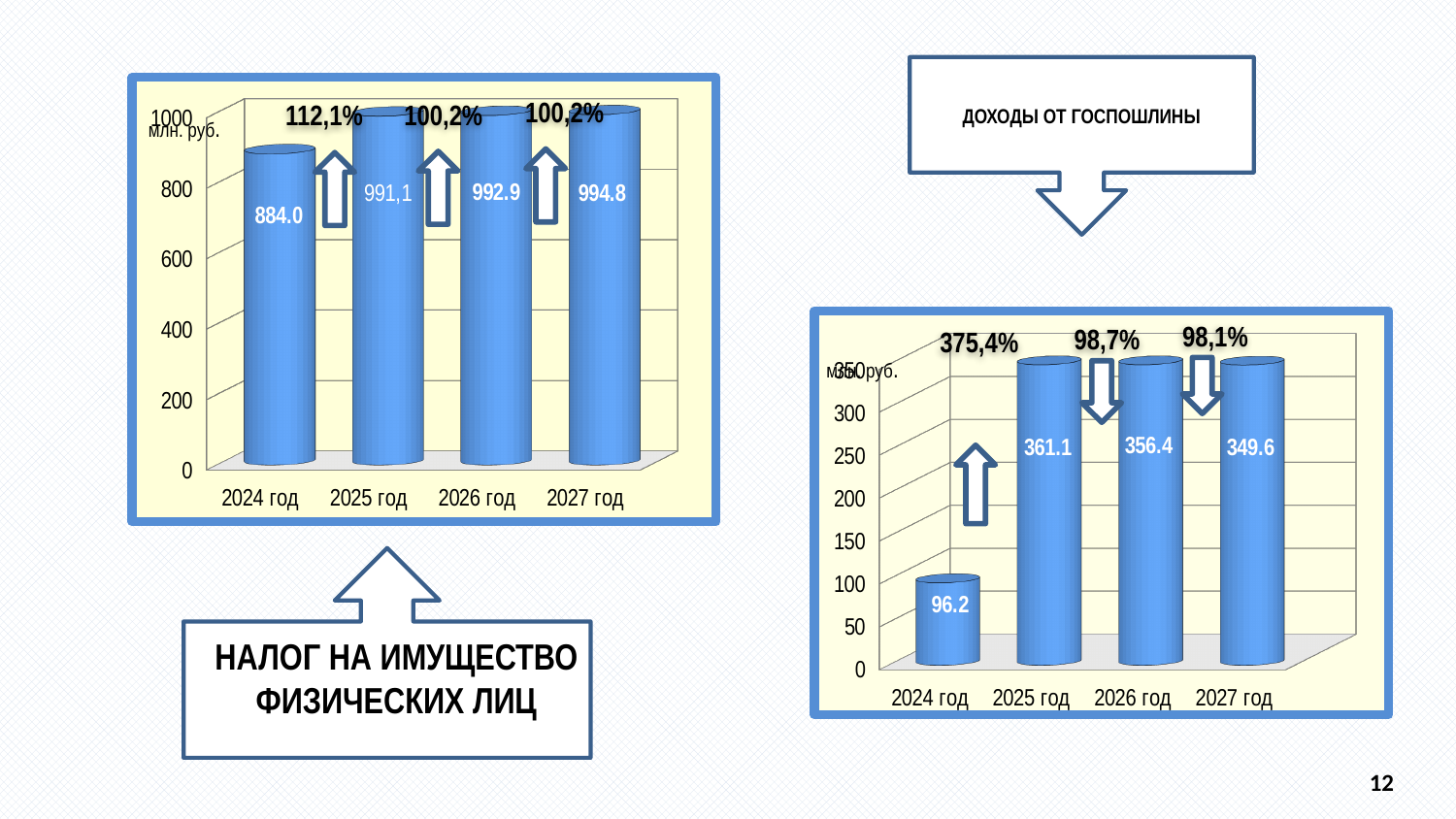
In the right chart (ДОХОДЫ ОТ ГОСПОШЛИНЫ), what is the value for 2026 год? 356.4 In the right chart (ДОХОДЫ ОТ ГОСПОШЛИНЫ), which year has the highest value? 2025 год In the right chart (ДОХОДЫ ОТ ГОСПОШЛИНЫ), what is the value for 2024 год? 96.2 In the left chart (НАЛОГ НА ИМУЩЕСТВО ФИЗИЧЕСКИХ ЛИЦ), what is the difference between the values for 2025 год and 2024 год? 107.1 In the right chart (ДОХОДЫ ОТ ГОСПОШЛИНЫ), what is the difference between the values for 2025 год and 2027 год? 11.5 How many years are shown on the x axis of the right chart (ДОХОДЫ ОТ ГОСПОШЛИНЫ)? 4 What type of chart is the left chart (НАЛОГ НА ИМУЩЕСТВО ФИЗИЧЕСКИХ ЛИЦ)? Bar chart In the right chart (ДОХОДЫ ОТ ГОСПОШЛИНЫ), which is larger, the value for 2024 год or the value for 2027 год? 2027 год In the left chart (НАЛОГ НА ИМУЩЕСТВО ФИЗИЧЕСКИХ ЛИЦ), what percentage label is shown above the 2025 год bar? 112,1% In the left chart (НАЛОГ НА ИМУЩЕСТВО ФИЗИЧЕСКИХ ЛИЦ), what is the value for 2024 год? 884.0 In the left chart (НАЛОГ НА ИМУЩЕСТВО ФИЗИЧЕСКИХ ЛИЦ), which year has the lowest value? 2024 год In the left chart (НАЛОГ НА ИМУЩЕСТВО ФИЗИЧЕСКИХ ЛИЦ), what is the value for 2027 год? 994.8